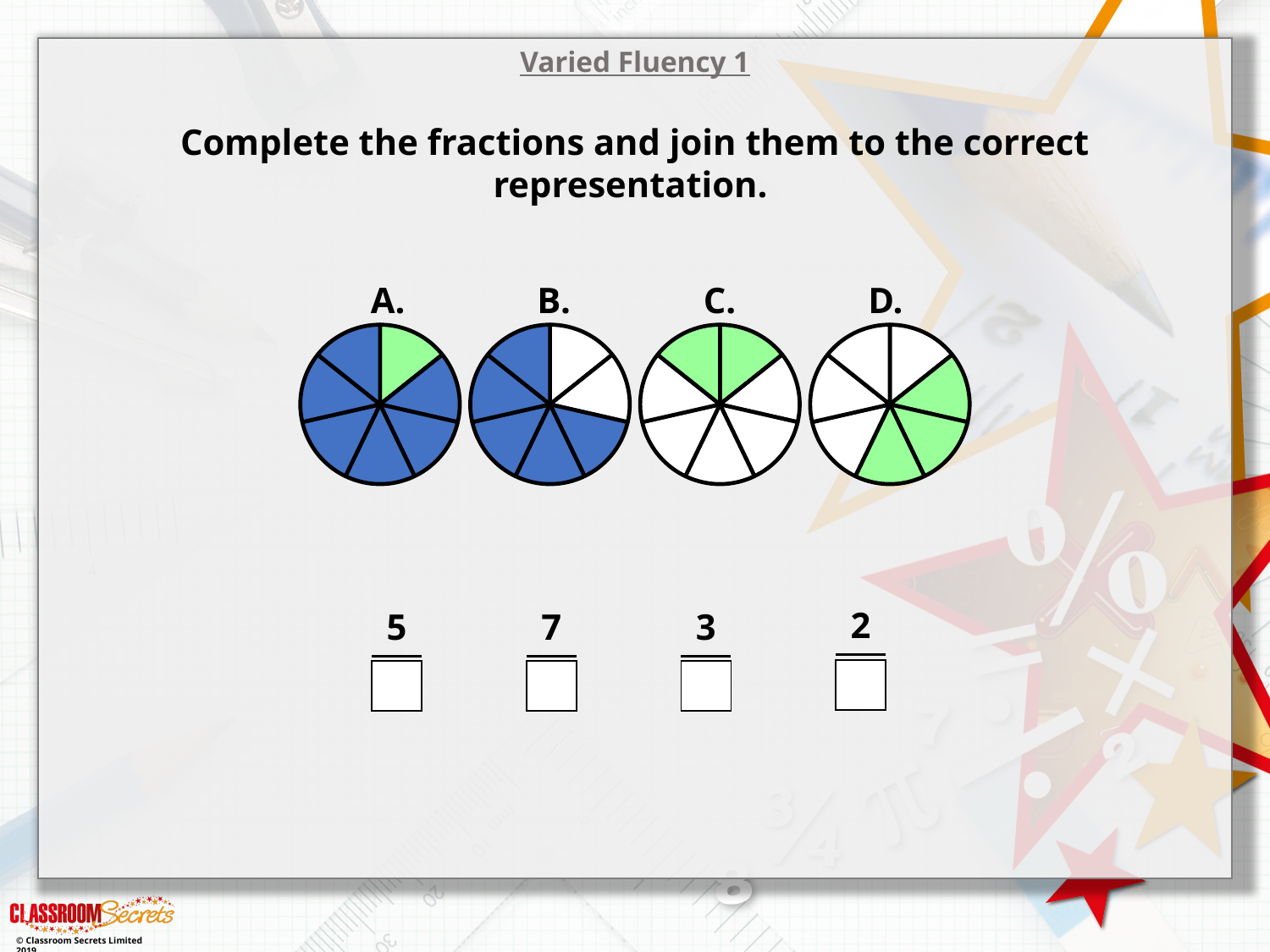
How many more parts are shaded in circle A than in circle B? 2 How many parts of circle C are shaded green? 2 Which circle has more shaded parts, B or D? B What colour are the shaded parts of circle B? Blue How many parts of circle B are shaded blue? 5 How many circle diagrams are shown on the slide? 4 What fraction of circle D is shaded green? 3/7 How many equal parts is circle A divided into? 7 How many parts of circle D are shaded green? 3 Which circle has the most shaded parts? A How many parts of circle A are shaded blue? 6 Which circle has the fewest shaded parts? C